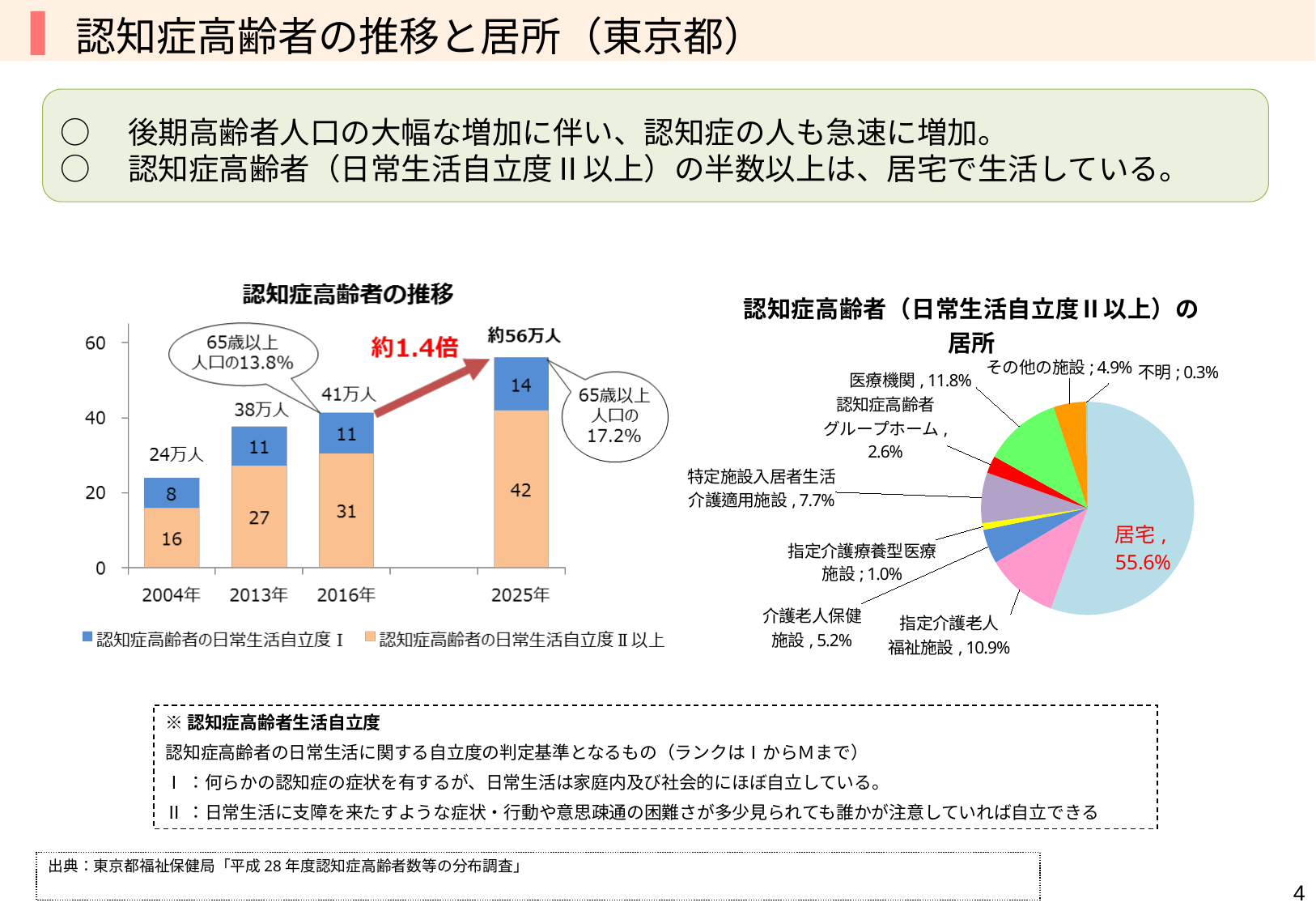
「認知症高齢者の推移」のグラフは、年を追うごとに値が増加していますか、減少していますか？ 増加 「認知症高齢者の推移」のグラフで、2025年と2004年の日常生活自立度Ⅱ以上の値の差はいくつですか？ 26 「認知症高齢者（日常生活自立度Ⅱ以上）の居所」の円グラフで、医療機関の割合は何％ですか？ 11.8% 「認知症高齢者の推移」のグラフは、どの種類のグラフですか？ 積み上げ棒グラフ 「認知症高齢者の推移」のグラフで、2016年の認知症高齢者の日常生活自立度Ⅱ以上の値はいくつですか？ 31 「認知症高齢者の推移」のグラフで、2013年の積み上げ棒の合計はいくつですか？ 38万人 「認知症高齢者（日常生活自立度Ⅱ以上）の居所」の円グラフで、居宅の割合は何％ですか？ 55.6% 「認知症高齢者（日常生活自立度Ⅱ以上）の居所」の円グラフで、最も割合が小さい項目はどれですか？ 不明 「認知症高齢者の推移」のグラフで、2025年の認知症高齢者の日常生活自立度Ⅰの値はいくつですか？ 14 「認知症高齢者の推移」のグラフの凡例には、いくつの系列がありますか？ 2 「認知症高齢者（日常生活自立度Ⅱ以上）の居所」の円グラフには、いくつの項目がありますか？ 9 「認知症高齢者の推移」のグラフで、合計が最も少ない年はどれですか？ 2004年